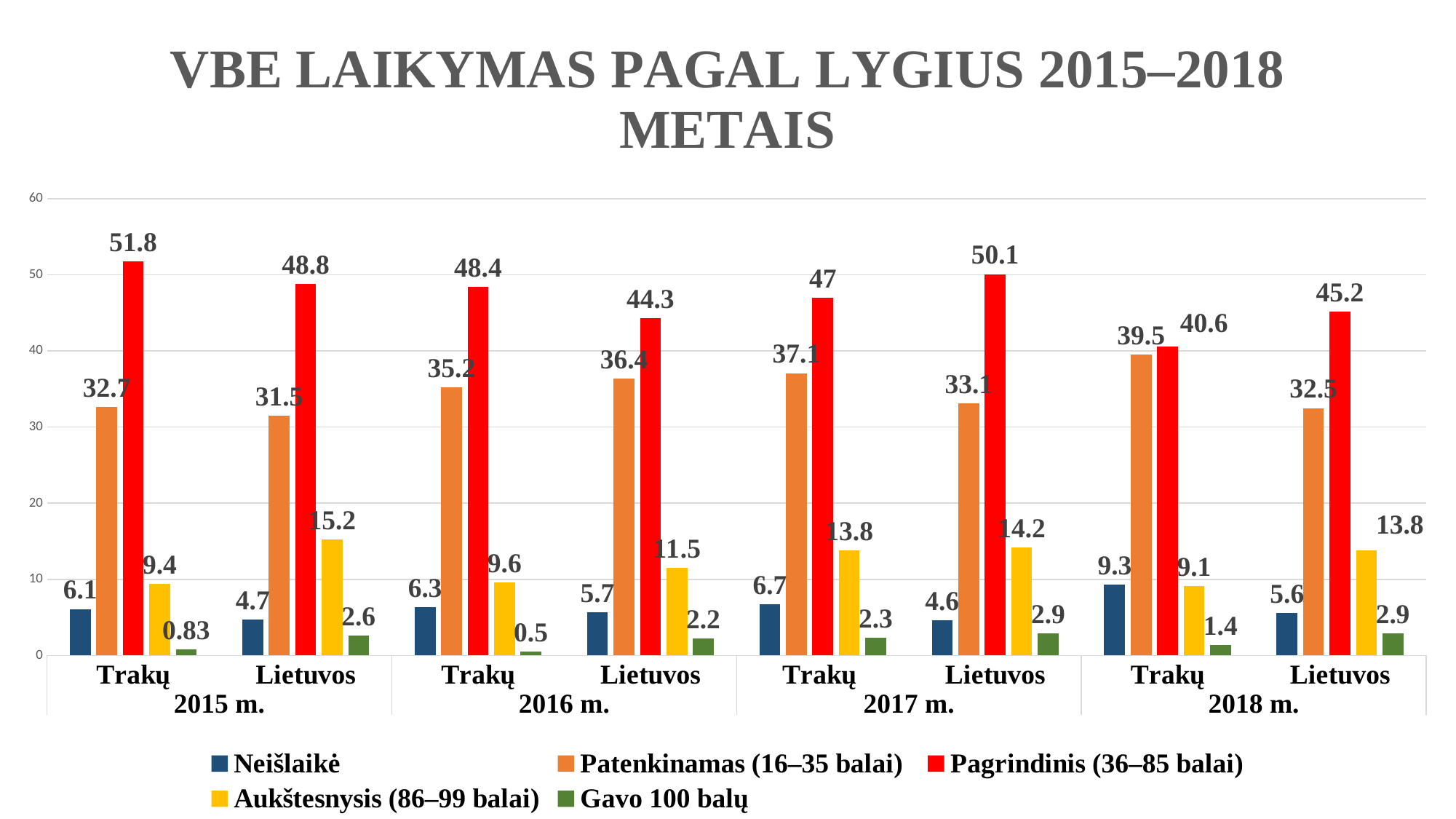
What is the value of Neišlaikė for Trakų in 2018 m.? 9.3 What is the value of Gavo 100 balų for Trakų in 2016 m.? 0.5 Which group and year has the lowest Gavo 100 balų value? Trakų, 2016 m. In which year and group does Pagrindinis (36–85 balai) reach its highest value? Trakų, 2015 m. Which is larger for Trakų in 2018 m.: Patenkinamas (16–35 balai) or Pagrindinis (36–85 balai)? Pagrindinis (36–85 balai) What kind of chart is shown on the slide? Bar chart What is the value of Pagrindinis (36–85 balai) for Trakų in 2015 m.? 51.8 What is the title of the chart? VBE LAIKYMAS PAGAL LYGIUS 2015–2018 METAIS What is the value of Aukštesnysis (86–99 balai) for Lietuvos in 2015 m.? 15.2 How many series does the legend list? 5 What is the difference between the Patenkinamas (16–35 balai) values for Trakų and Lietuvos in 2018 m.? 7 How does the Pagrindinis (36–85 balai) value for Trakų change from 2015 m. to 2018 m.? It falls